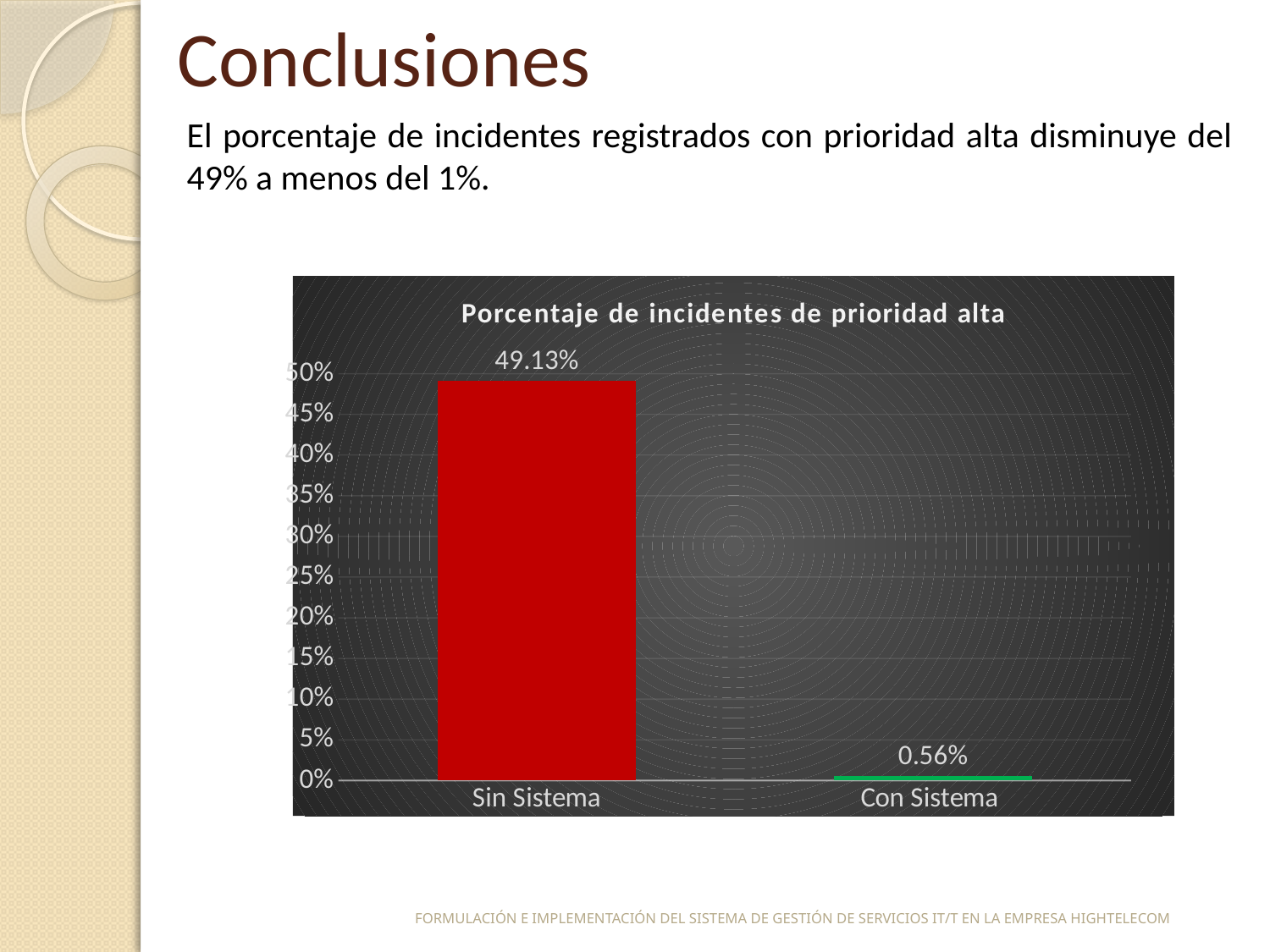
What is the value for Sin Sistema? 49.13% Which category has the lowest value? Con Sistema Which is larger, the value for Sin Sistema or the value for Con Sistema? Sin Sistema What kind of chart is shown on the slide? bar chart What is the title of the chart? Porcentaje de incidentes de prioridad alta How many categories are shown on the x axis? 2 Which category has the highest value? Sin Sistema Is the value for Con Sistema greater or less than 5%? less What is the value for Con Sistema? 0.56% Is the value for Sin Sistema greater or less than 45%? greater What is the difference between the values for Sin Sistema and Con Sistema? 48.57% What colour is the bar for Sin Sistema? red